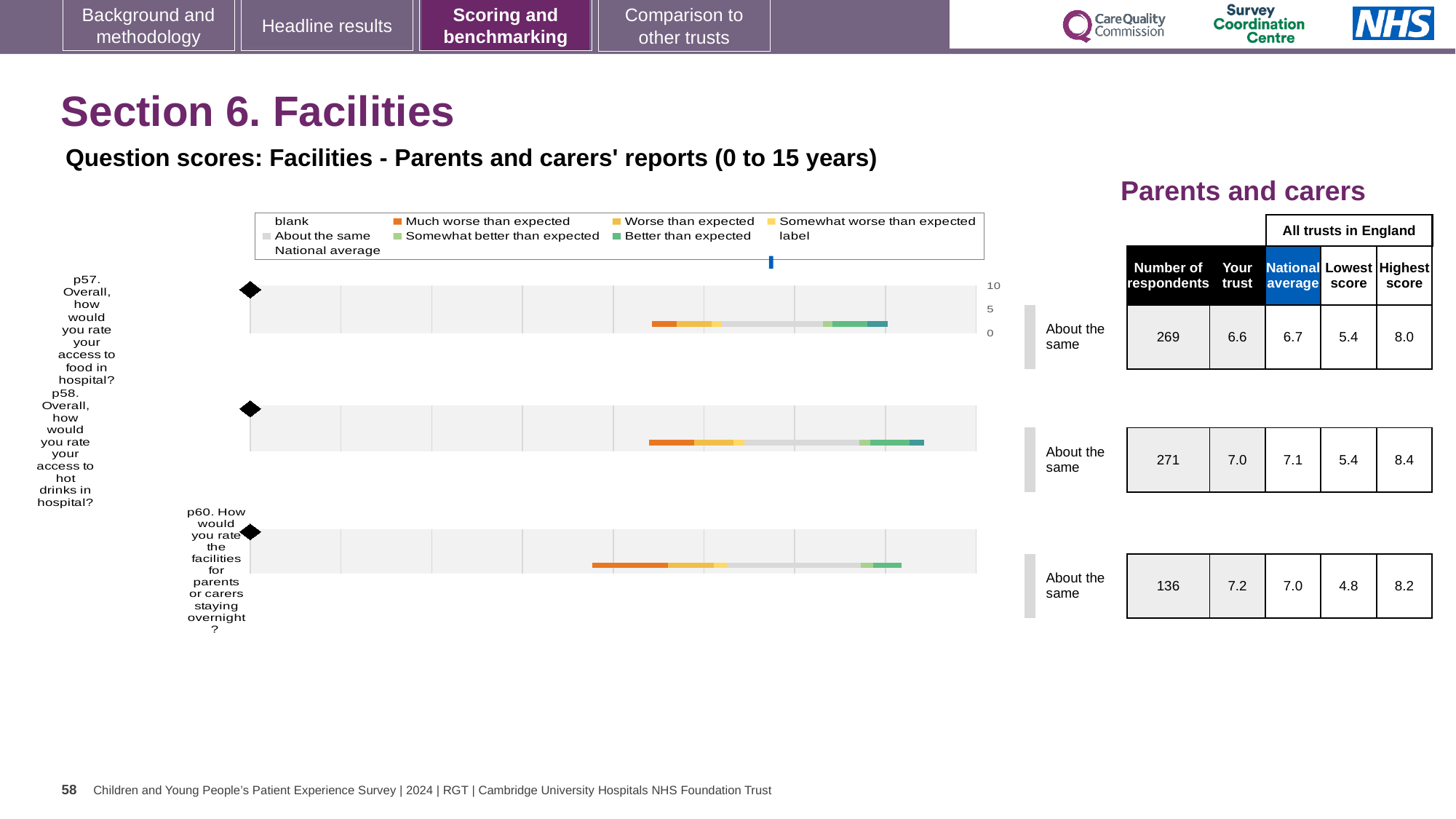
What is the maximum value shown on the score axis of the charts? 10 For p60, which is larger: the 'Your trust' score or the national average? Your trust How many survey questions (bars) are plotted on the slide? 3 What is the national average score for p58 (access to hot drinks in hospital)? 7.1 Which question has the lowest 'Lowest score' across all trusts in England? p60 What is the highest score among all trusts in England for p57? 8.0 What is the 'Your trust' score for p57 (access to food in hospital)? 6.6 What kind of chart is used to show the question scores on this slide? bar chart How many respondents answered p60 (facilities for parents or carers staying overnight)? 136 For p58, what is the difference between the highest score and the lowest score across all trusts in England? 3.0 What benchmark category is shown for all three questions? About the same Which question has the highest 'Your trust' score? p60